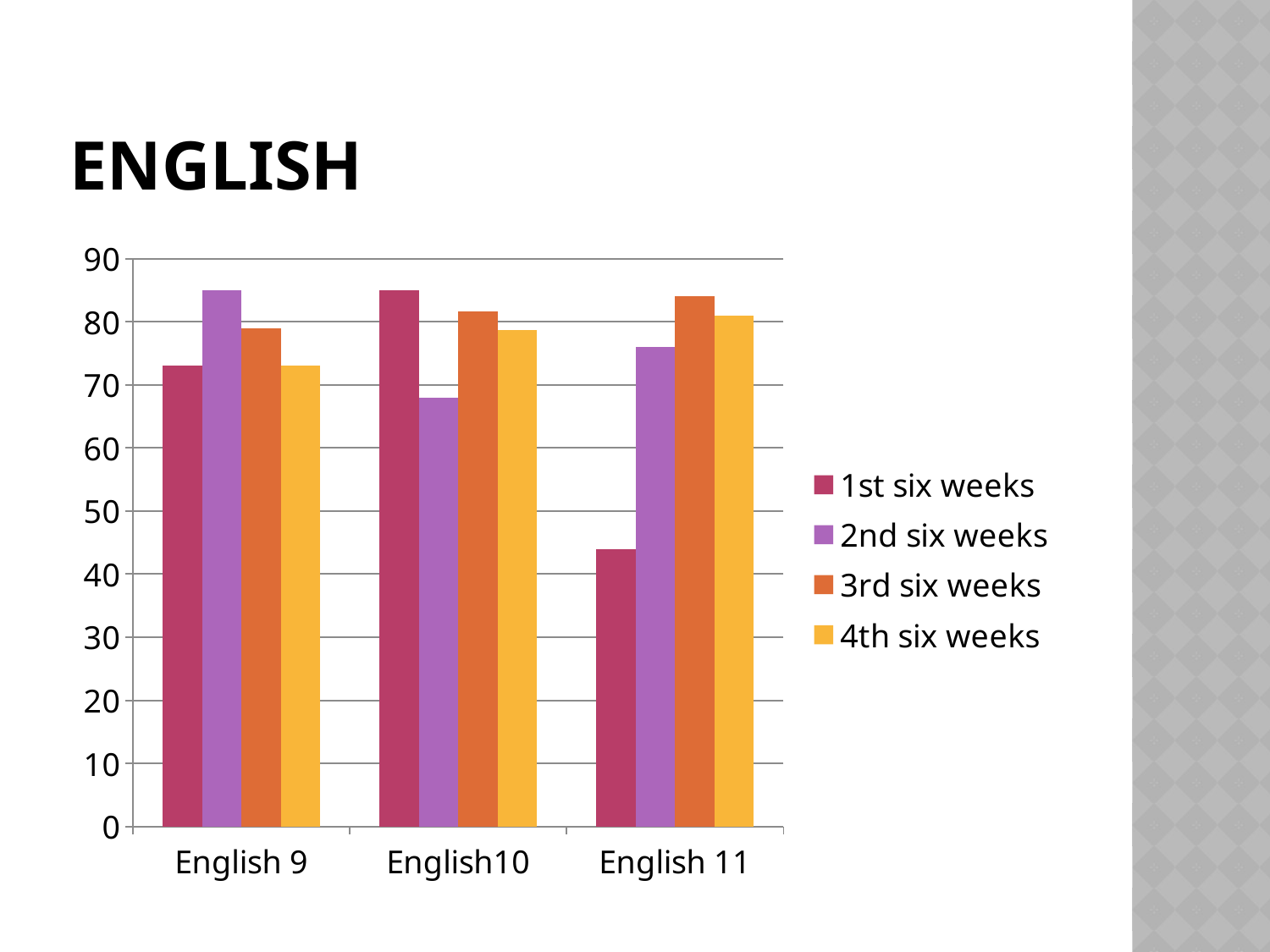
Which series has the highest value in English 9? 2nd six weeks How many categories are shown on the x axis of the chart? 3 Is the value for 2nd six weeks in English10 greater or less than 70? less What is the title of the slide containing the chart? ENGLISH What kind of chart is shown on the slide? bar chart How many series does the chart's legend list? 4 Is the value for 2nd six weeks in English 9 greater or less than 80? greater Is the value for 3rd six weeks in English 11 greater or less than 80? greater Which category has the lowest value for 1st six weeks? English 11 Which legend entry is shown in purple? 2nd six weeks In English10, which is larger: the value for 1st six weeks or the value for 2nd six weeks? 1st six weeks